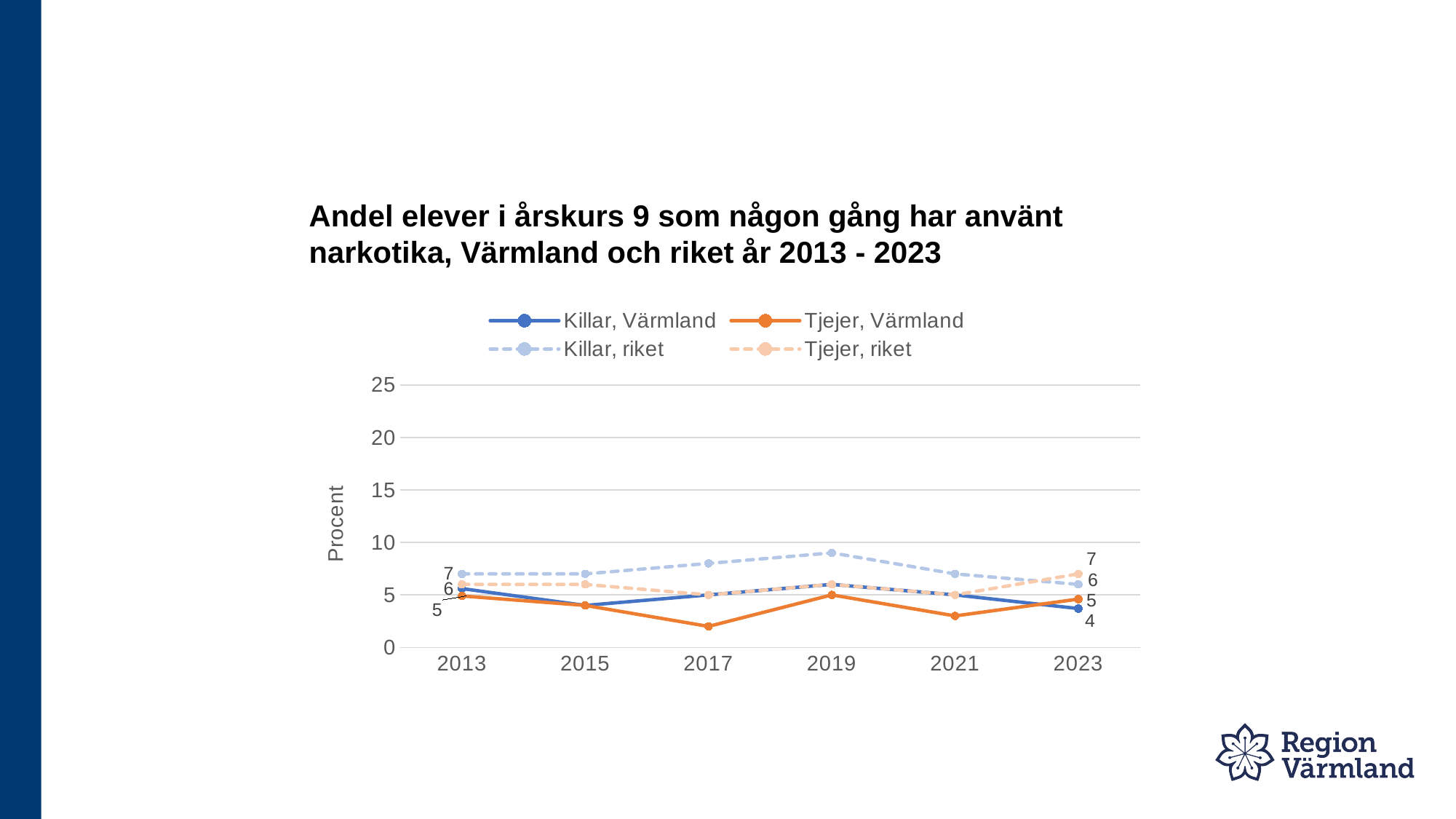
What is the value for Killar, riket in 2013? 7 How many years are shown on the x axis? 6 How many series does the legend list? 4 What kind of chart is shown on the slide? line chart What is the value for Tjejer, riket in 2023? 7 By how much did the value for Killar, Värmland fall from 2013 to 2023? 2 What is the value for Killar, Värmland in 2023? 4 What is the label on the y axis? Procent Is the value for Tjejer, Värmland in 2017 greater or less than 5? less Which series has the highest value in 2023? Tjejer, riket What is the value for Killar, Värmland in 2013? 6 What is the value for Tjejer, Värmland in 2013? 5